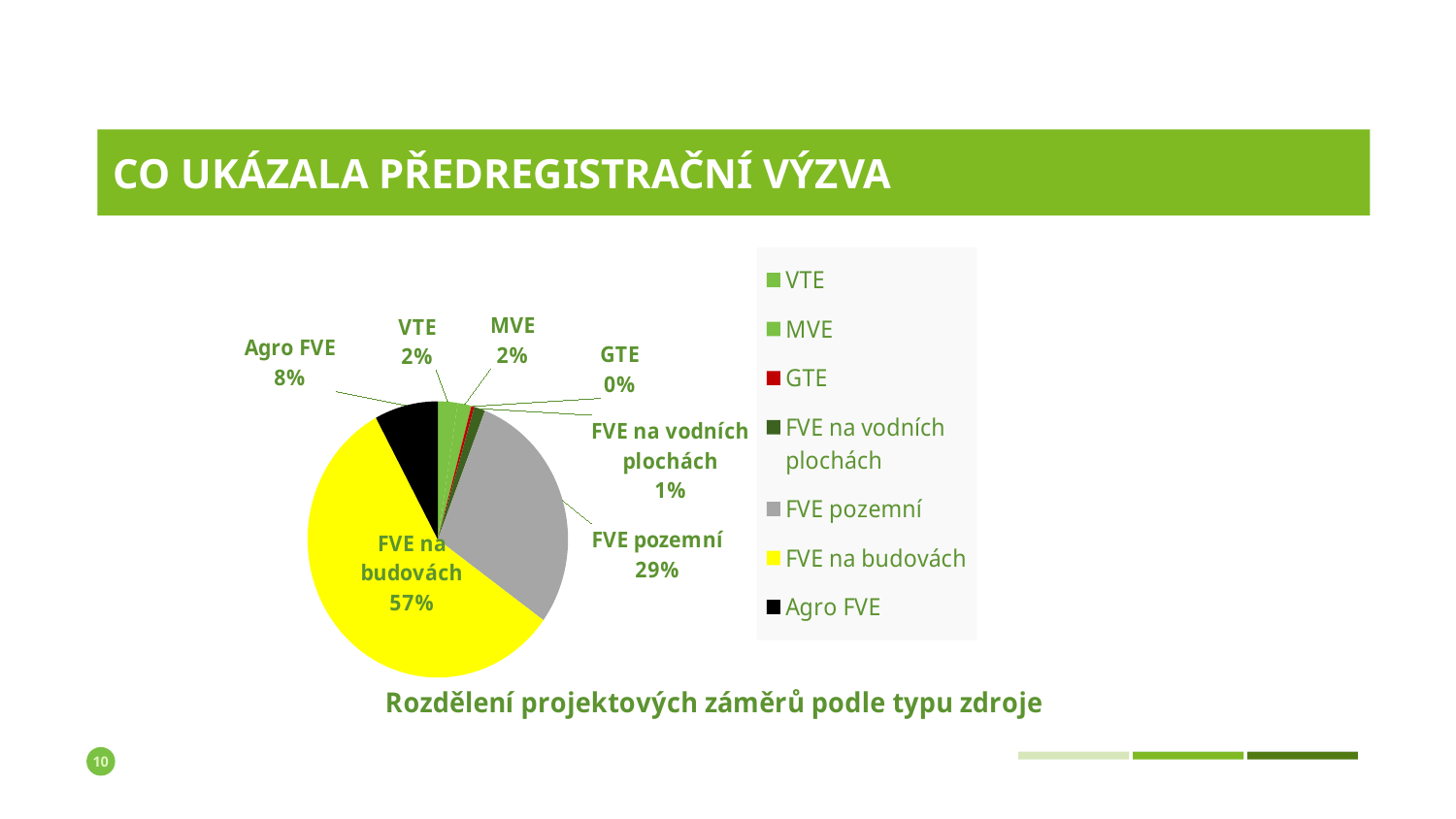
What is the value shown for Agro FVE? 8% What is the caption below the pie chart? Rozdělení projektových záměrů podle typu zdroje What is the value shown for FVE na vodních plochách? 1% What share of the pie does FVE na budovách have? 57% Which is larger, the share of Agro FVE or the share of VTE? Agro FVE What is the value shown for GTE? 0% Which category has the largest share of the pie? FVE na budovách What is the difference between the shares of FVE na budovách and FVE pozemní? 28% Which category has the smallest share of the pie? GTE What is the value shown for FVE pozemní? 29% How many entries does the legend list? 7 What type of chart is shown on the slide? pie chart